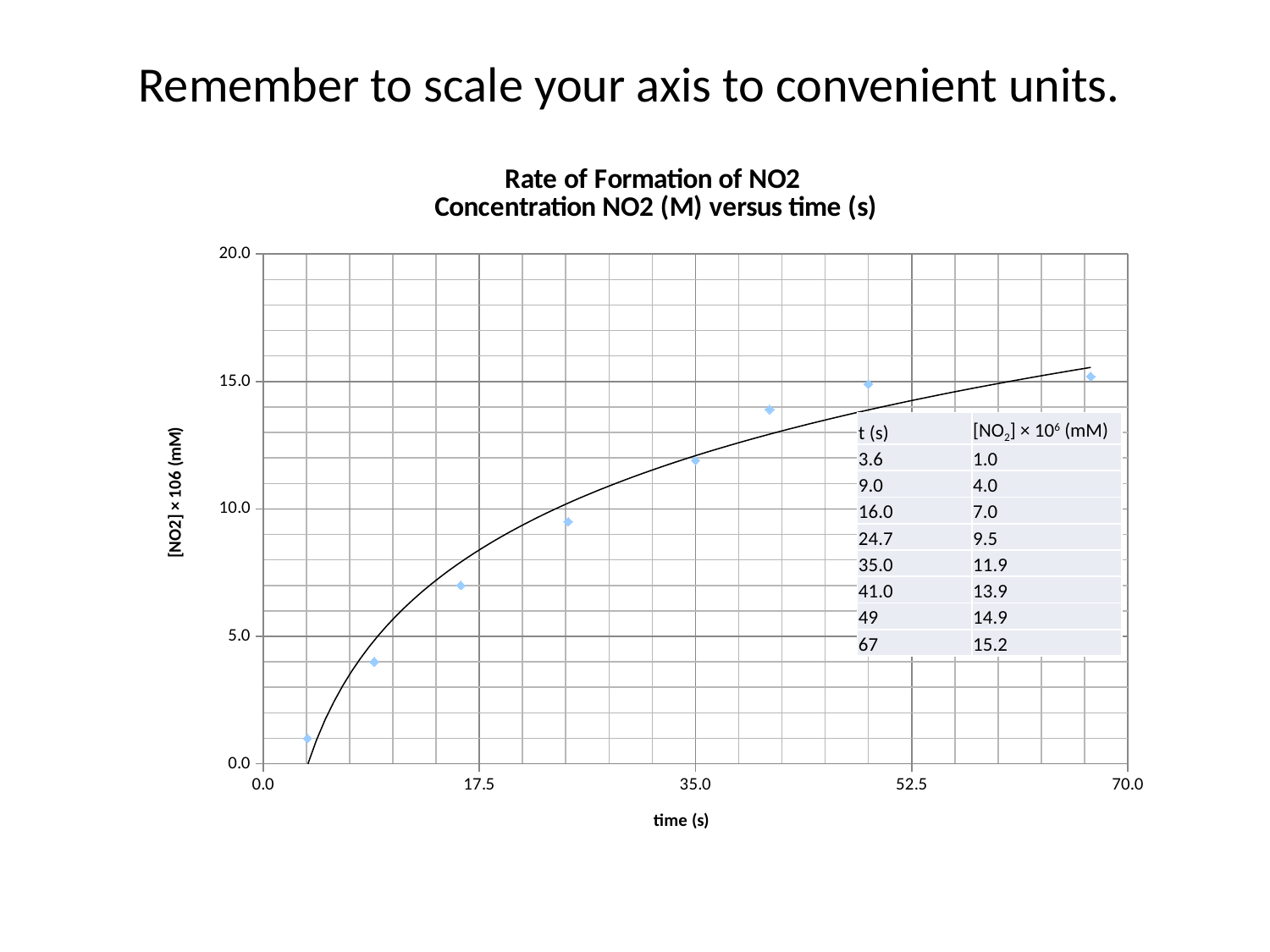
What kind of chart is shown on the slide? Scatter plot Do the concentration values rise or fall as time increases? rise How many data points are plotted on the chart? 8 According to the data table, what is the [NO2] × 10^6 (mM) value at t = 16.0 s? 7.0 What is the difference between the concentration values at t = 67 s and t = 3.6 s? 14.2 At which time (s) is the concentration value highest? 67 What is the title of the chart? Rate of Formation of NO2 Concentration NO2 (M) versus time (s) Which has the larger concentration value, t = 41.0 s or t = 35.0 s? 41.0 At which time (s) is the concentration value lowest? 3.6 Is the concentration value at t = 24.7 s greater or less than 10.0? less According to the data table, what is the [NO2] × 10^6 (mM) value at t = 35.0 s? 11.9 What is the label of the x axis? time (s)